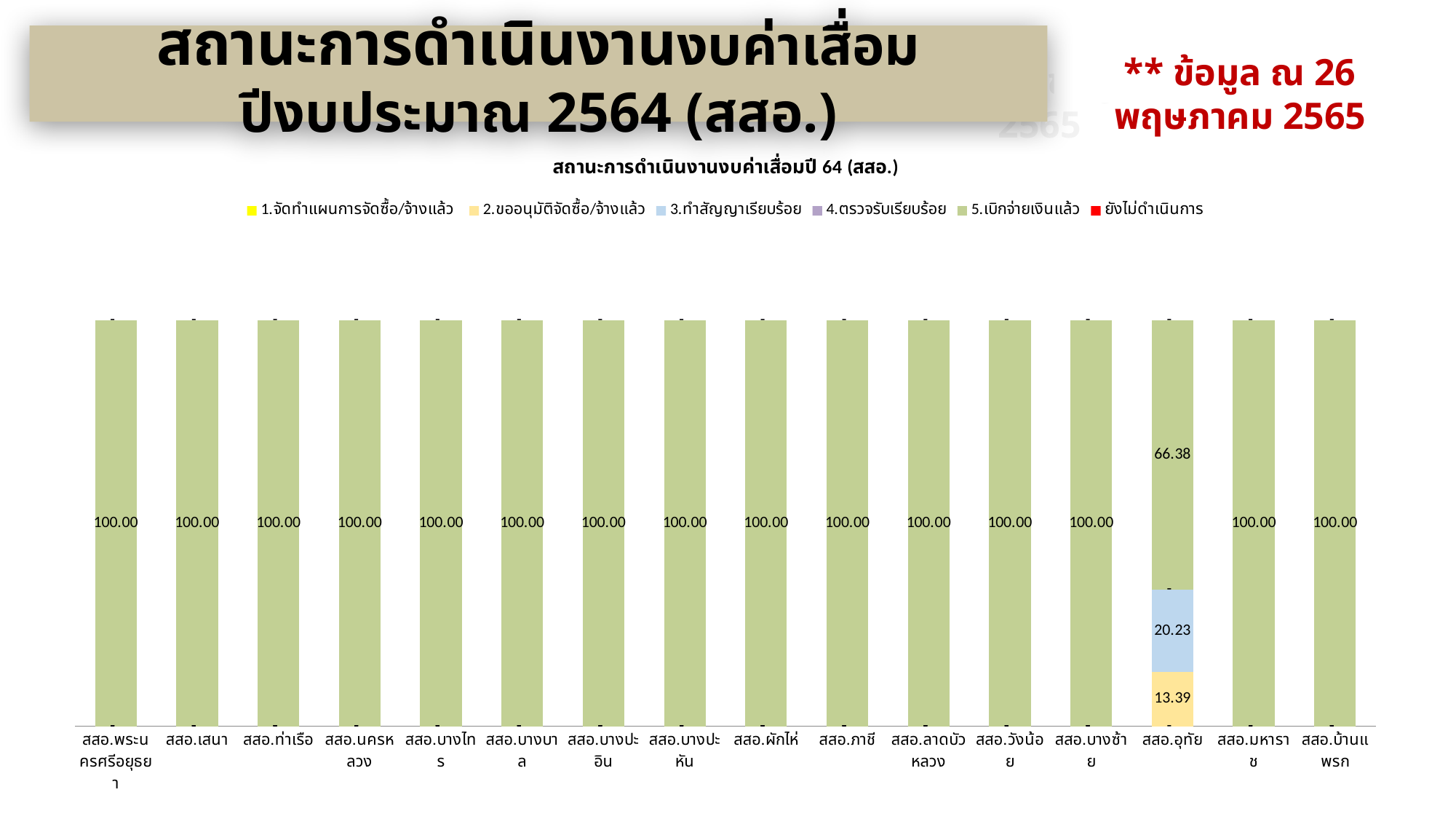
What is the difference between the 5.เบิกจ่ายเงินแล้ว value and the 3.ทำสัญญาเรียบร้อย value for สสอ.อุทัย? 46.15 What is the value of 5.เบิกจ่ายเงินแล้ว for สสอ.เสนา? 100.00 For สสอ.อุทัย, which is larger: 3.ทำสัญญาเรียบร้อย or 2.ขออนุมัติจัดซื้อ/จ้างแล้ว? 3.ทำสัญญาเรียบร้อย How many categories (สสอ.) are shown on the x axis? 16 What kind of chart is shown on the slide? bar chart What is the value of 5.เบิกจ่ายเงินแล้ว for สสอ.อุทัย? 66.38 What is the total of the stacked bar for สสอ.อุทัย? 100.00 What is the value of 2.ขออนุมัติจัดซื้อ/จ้างแล้ว for สสอ.อุทัย? 13.39 How many series does the legend list? 6 What is the value of 3.ทำสัญญาเรียบร้อย for สสอ.อุทัย? 20.23 What is the difference between the 3.ทำสัญญาเรียบร้อย value and the 2.ขออนุมัติจัดซื้อ/จ้างแล้ว value for สสอ.อุทัย? 6.84 Which category has the lowest value for 5.เบิกจ่ายเงินแล้ว? สสอ.อุทัย